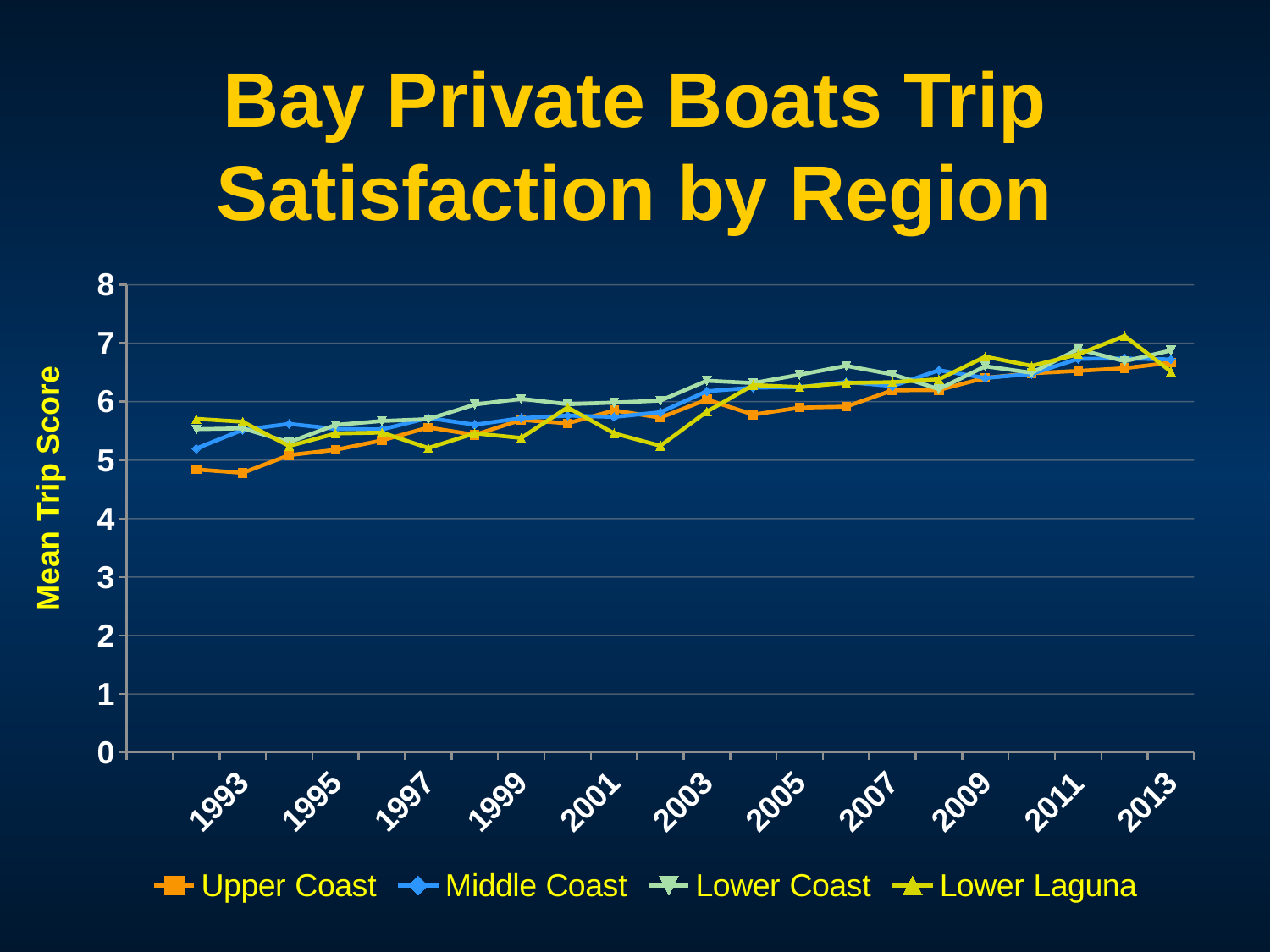
How many year labels are shown on the x axis? 11 What is the title of the chart? Bay Private Boats Trip Satisfaction by Region How many series does the legend list? 4 What is the label on the vertical axis? Mean Trip Score Is the value for Upper Coast in 1993 greater or less than 5? less Which series has the lowest value in 1993? Upper Coast Is the value for Lower Laguna in 2002 greater or less than 6? less Do the Upper Coast values generally rise or fall from 1993 to 2013? rise Is the value for Middle Coast in 2013 greater or less than 6? greater In 1993, which is larger: the value for Upper Coast or the value for Lower Laguna? Lower Laguna What kind of chart is shown on the slide? line chart